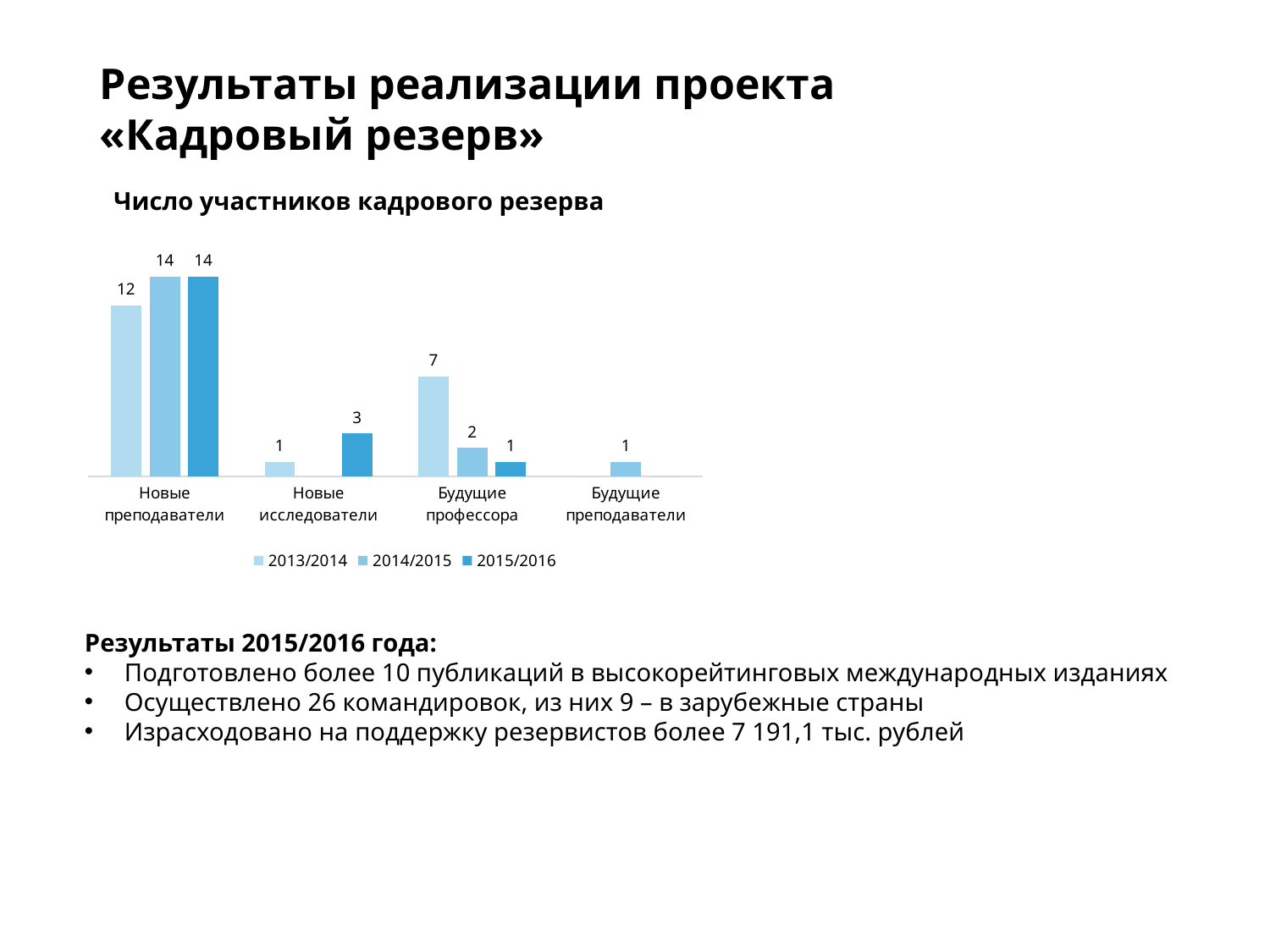
What is the value for Новые преподаватели in the 2013/2014 series? 12 Which is larger for Новые преподаватели: the 2013/2014 value or the 2014/2015 value? 2014/2015 What is the difference between the 2013/2014 and 2015/2016 values for Будущие профессора? 6 What is the value for Будущие преподаватели in the 2014/2015 series? 1 How many series does the legend list? 3 Which category has the highest value in the 2015/2016 series? Новые преподаватели What is the value for Новые исследователи in the 2015/2016 series? 3 How many categories are shown on the x axis? 4 What kind of chart is shown on the slide? Bar chart What is the title of the chart? Число участников кадрового резерва What is the value for Будущие профессора in the 2013/2014 series? 7